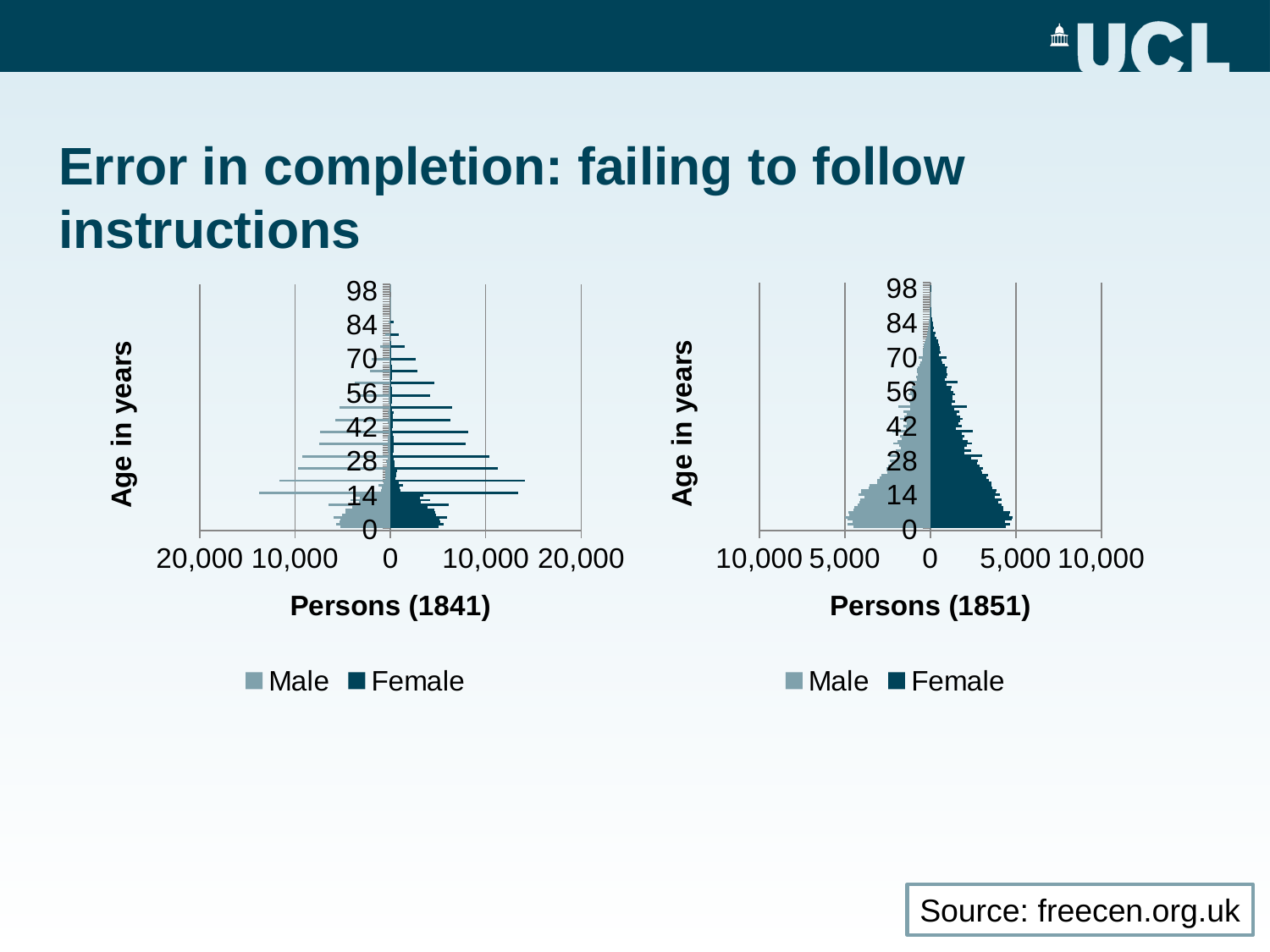
In the Persons (1851) chart, is the Female value at age 0 greater or less than 5,000? less In the Persons (1851) chart, is the Male value at age 0 greater or less than 10,000? less What kind of chart is the Persons (1841) chart? bar chart In the Persons (1841) chart, is the Male value at age 84 greater or less than 10,000? less In the Persons (1851) chart, as age increases from 0 to 98, do the bar lengths generally rise or fall? fall What are the two series named in the legend of the Persons (1851) chart? Male and Female How many age tick labels are shown on the vertical axis of the Persons (1851) chart? 8 How many series does the legend of the Persons (1841) chart list? 2 What is the largest value labelled on the horizontal axis of the Persons (1841) chart? 20,000 What is the vertical axis title of the Persons (1841) chart? Age in years What kind of chart is the Persons (1851) chart? bar chart